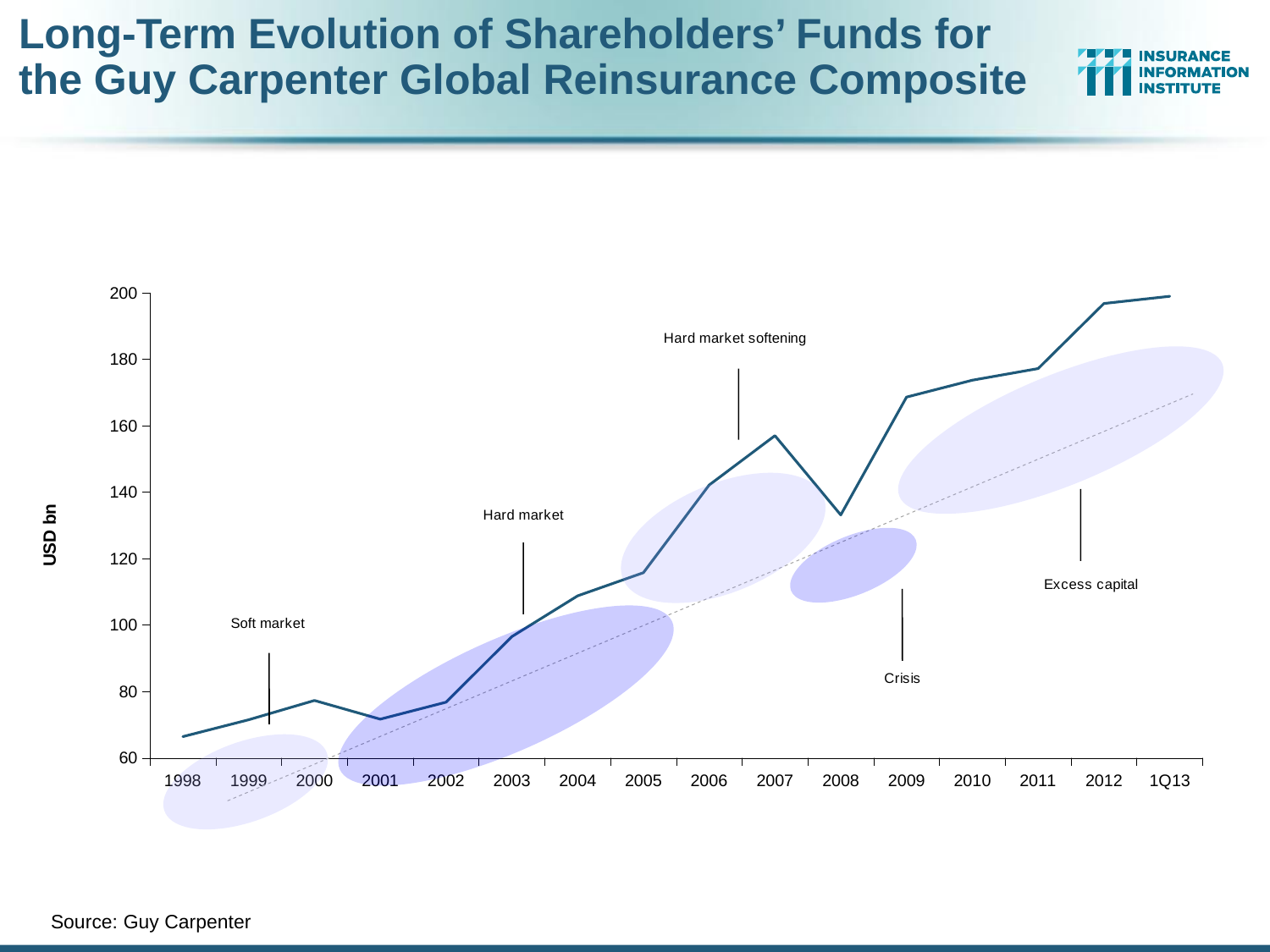
Is the value for 2012 greater or less than 180? greater Is the value for 2008 greater or less than 140? less Which is larger, the value for 2007 or the value for 2008? 2007 Is the value for 2007 greater or less than 140? greater What kind of chart is shown on the slide? line chart What is the source cited for the chart? Guy Carpenter Which year has the lowest value of shareholders' funds? 1998 What is the label on the vertical axis? USD bn Overall, do shareholders' funds rise or fall from 1998 to 1Q13? rise How many time points are plotted along the x axis? 16